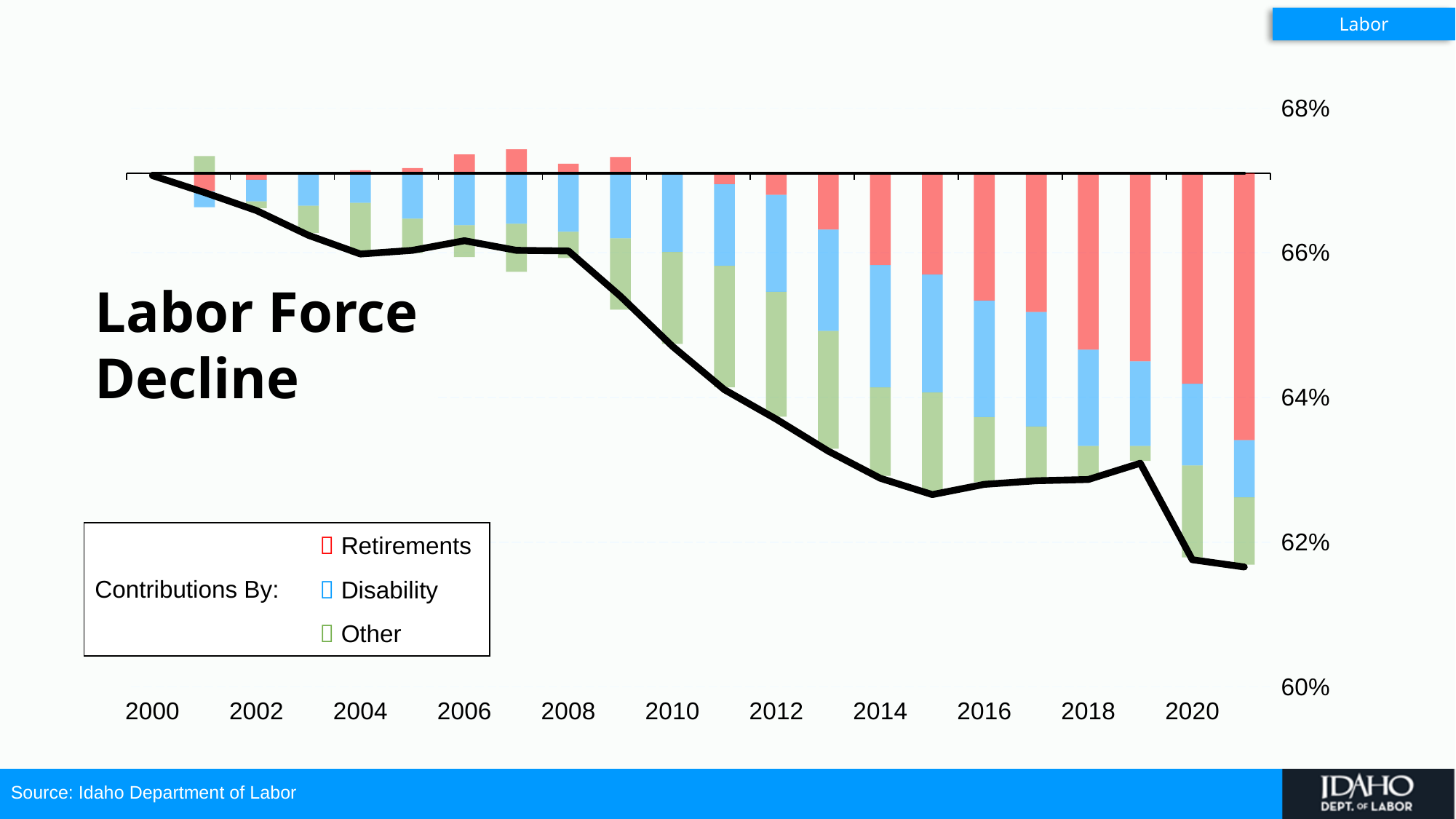
What are the three series named in the legend? Retirements, Disability, Other How many year labels are shown on the x axis? 11 What is the title of the chart? Labor Force Decline How many series does the legend list under "Contributions By:"? 3 Is the value of the black line for 2014 greater or less than 64%? less Is the value of the black line for 2000 greater or less than 66%? greater Is the value of the black line for 2010 greater or less than 64%? greater Which year has the highest value on the black line, 2000 or 2020? 2000 What kind of chart is shown on the slide? A stacked bar chart combined with a line chart In which year does the black line reach its highest value? 2000 Does the black line rise or fall overall from 2000 to 2020? Fall